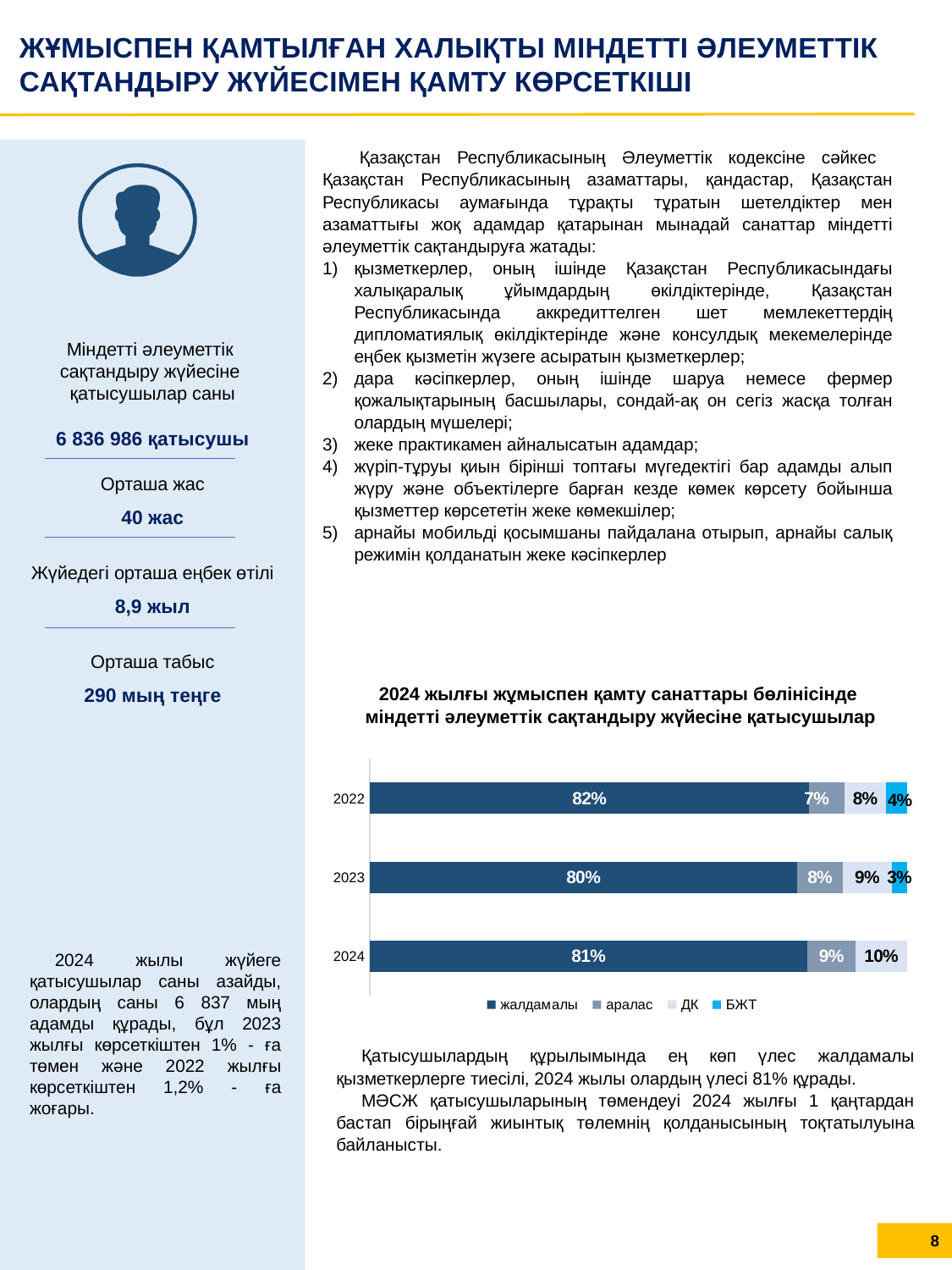
How many years (categories) are shown on the chart? 3 What is the share of жалдамалы in 2024? 81% What is the share of ДК in 2022? 8% What is the share of аралас in 2023? 8% Which is larger: the share of БЖТ in 2022 or in 2023? 2022 What is the difference between the share of ДК in 2024 and in 2022? 2% In which year is the share of жалдамалы the highest? 2022 In which year is the share of аралас the lowest? 2022 What kind of chart is shown on the slide? bar chart Which series is shown in the darkest blue colour on the chart? жалдамалы How many series does the chart legend list? 4 What is the share of БЖТ in 2023? 3%